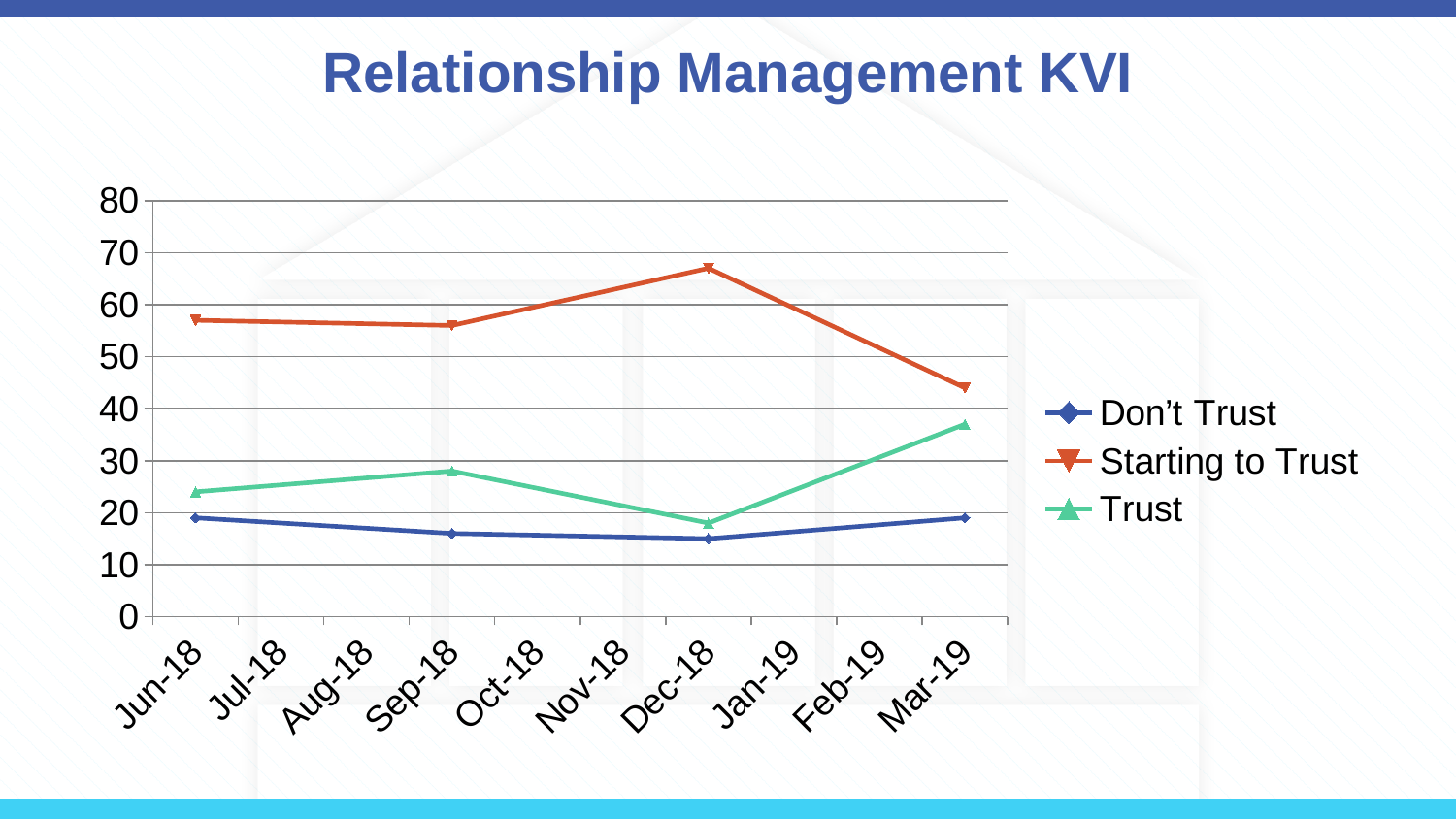
Is the value for Starting to Trust at Dec-18 greater or less than 60? greater Which series has the highest value at Dec-18? Starting to Trust How many month labels are shown on the x axis? 10 At Mar-19, which is larger: Trust or Don't Trust? Trust How many series does the legend list? 3 Is the value for Starting to Trust at Mar-19 greater or less than 50? less What is the title of the chart? Relationship Management KVI What colour is the line for the Trust series? green Does the Starting to Trust series rise or fall between Dec-18 and Mar-19? fall At which month does the Starting to Trust series reach its lowest value? Mar-19 Is the value for Trust at Mar-19 greater or less than 30? greater What kind of chart is shown on the slide? line chart